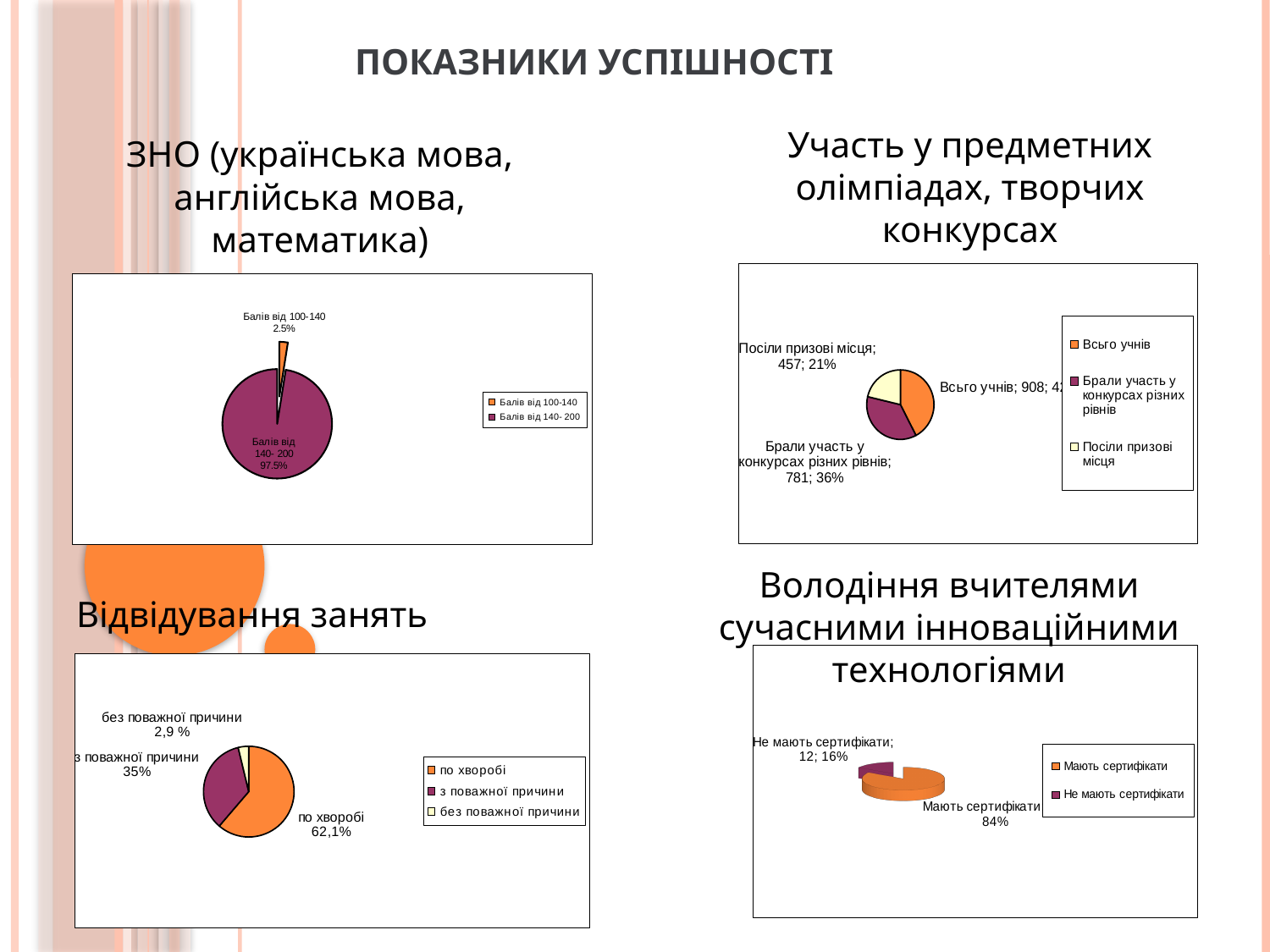
In the chart titled "Володіння вчителями сучасними інноваційними технологіями", how many slices does the pie have? 2 In the chart titled "Відвідування занять", what percentage is shown for "по хворобі"? 62,1% In the chart titled "Участь у предметних олімпіадах, творчих конкурсах", what percentage is shown for "Посіли призові місця"? 21% What kind of chart is used for "ЗНО (українська мова, англійська мова, математика)"? Pie chart In the chart titled "Участь у предметних олімпіадах, творчих конкурсах", what value is shown for "Всього учнів"? 908 In the chart titled "Участь у предметних олімпіадах, творчих конкурсах", what value is shown for "Брали участь у конкурсах різних рівнів"? 781 In the chart titled "ЗНО (українська мова, англійська мова, математика)", what percentage is shown for "Балів від 100-140"? 2.5% How many entries does the legend list in the chart titled "Участь у предметних олімпіадах, творчих конкурсах"? 3 In the chart titled "Участь у предметних олімпіадах, творчих конкурсах", what is the difference between the values for "Брали участь у конкурсах різних рівнів" and "Посіли призові місця"? 324 In the chart titled "ЗНО (українська мова, англійська мова, математика)", what percentage is shown for "Балів від 140- 200"? 97.5% In the chart titled "Відвідування занять", which category has the smallest share? без поважної причини In the chart titled "Володіння вчителями сучасними інноваційними технологіями", what percentage is shown for "Мають сертифікати"? 84%